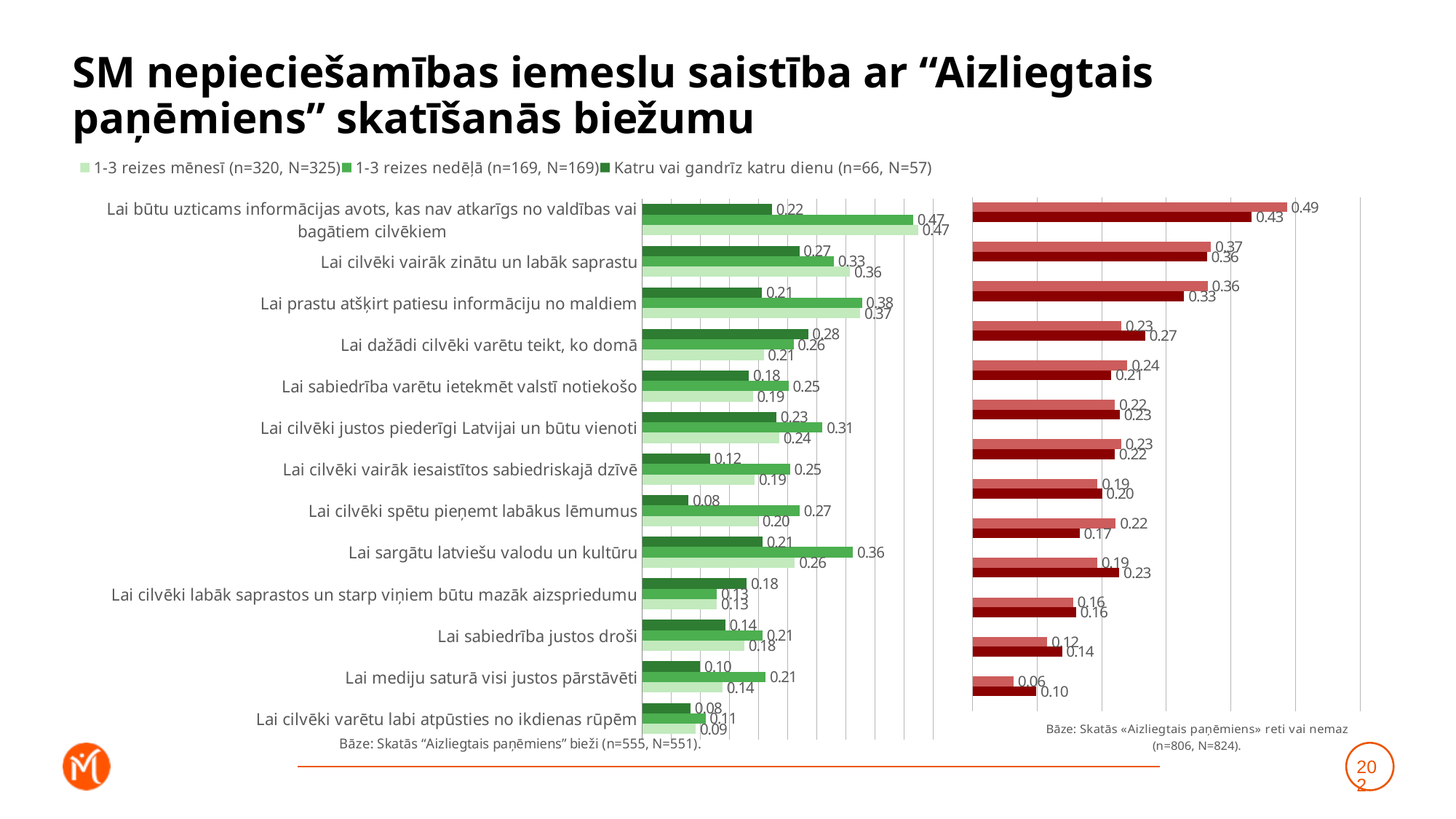
What type of chart is shown on the left side of the slide? bar chart In the left chart, what is the value for "Lai cilvēki spētu pieņemt labākus lēmumus" in the "Katru vai gandrīz katru dienu" series? 0.08 In the left chart, which category has the highest value in the "1-3 reizes nedēļā" series? Lai būtu uzticams informācijas avots, kas nav atkarīgs no valdības vai bagātiem cilvēkiem In the left chart, what is the value for "Lai cilvēki vairāk zinātu un labāk saprastu" in the "1-3 reizes mēnesī" series? 0.36 In the left chart, which category has the lowest value in the "1-3 reizes mēnesī" series? Lai cilvēki varētu labi atpūsties no ikdienas rūpēm What is the highest value labelled in the right chart? 0.49 What base (Bāze) is stated below the left chart? Skatās "Aizliegtais paņēmiens" bieži (n=555, N=551) How many series does the legend of the left chart list? 3 In the left chart, what is the difference between the "1-3 reizes nedēļā" and "Katru vai gandrīz katru dienu" values for "Lai prastu atšķirt patiesu informāciju no maldiem"? 0.17 In the left chart, what is the value for "Lai sargātu latviešu valodu un kultūru" in the "1-3 reizes nedēļā" series? 0.36 In the left chart, for "Lai dažādi cilvēki varētu teikt, ko domā", which series has the larger value: "Katru vai gandrīz katru dienu" or "1-3 reizes mēnesī"? Katru vai gandrīz katru dienu How many categories are plotted in the left chart? 13